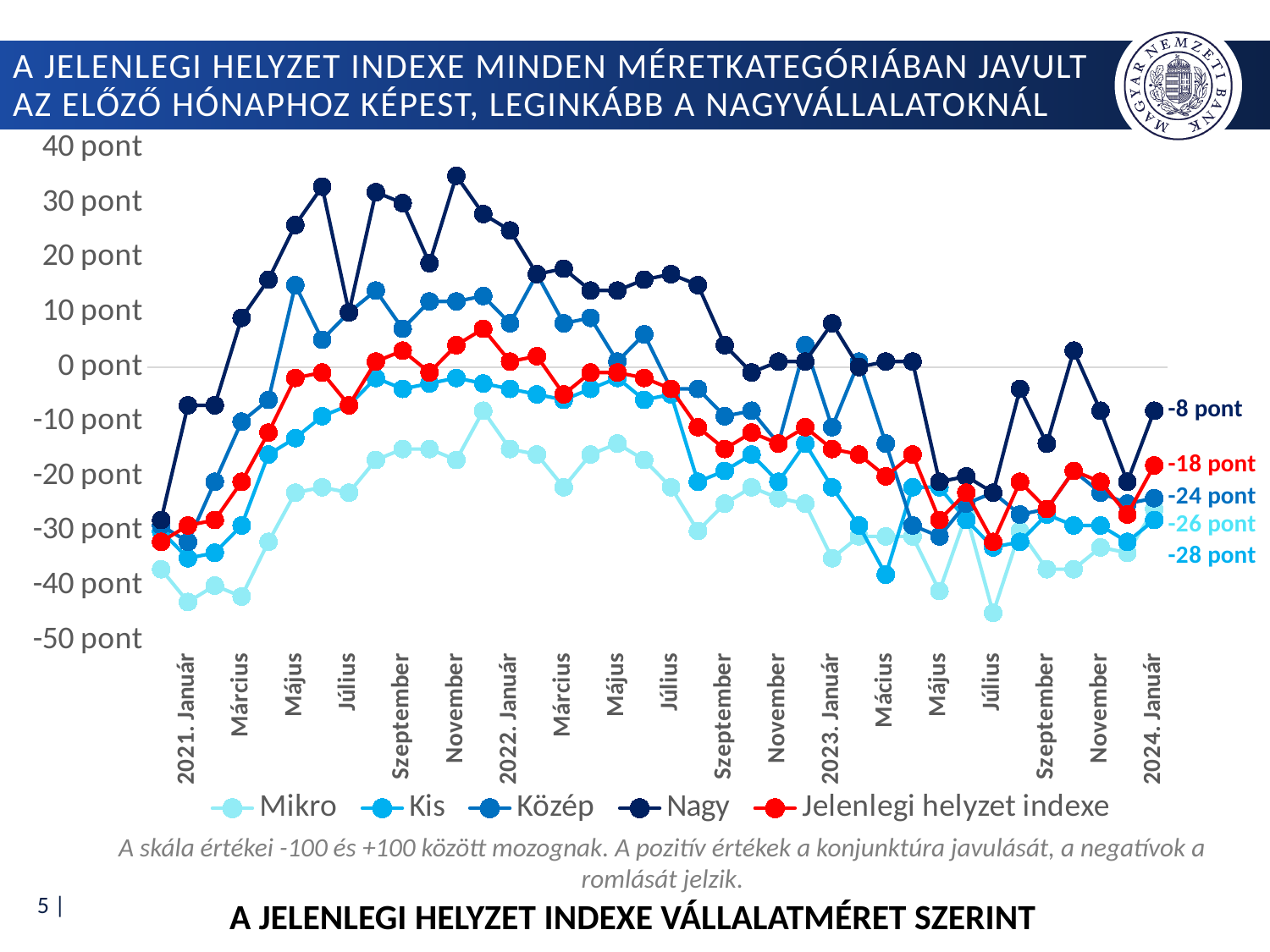
What is the value of the Mikro series at 2024. Január? -26 pont How many series does the legend list? 5 Which series has the highest value at 2024. Január? Nagy What is the value of the Nagy series at 2024. Január? -8 pont What kind of chart is shown on the slide? line chart Does the Nagy series rise or fall between 2021. Január and 2021. Május? rise Which series has the lowest value at 2024. Január? Kis What is the value of the Jelenlegi helyzet indexe series at 2024. Január? -18 pont What is the difference between the Nagy and Mikro values at 2024. Január? 18 pont At 2024. Január, which is larger: the Közép value or the Kis value? Közép Is the value of the Nagy series at 2021. November greater or less than 30 pont? greater What is the value of the Kis series at 2024. Január? -28 pont